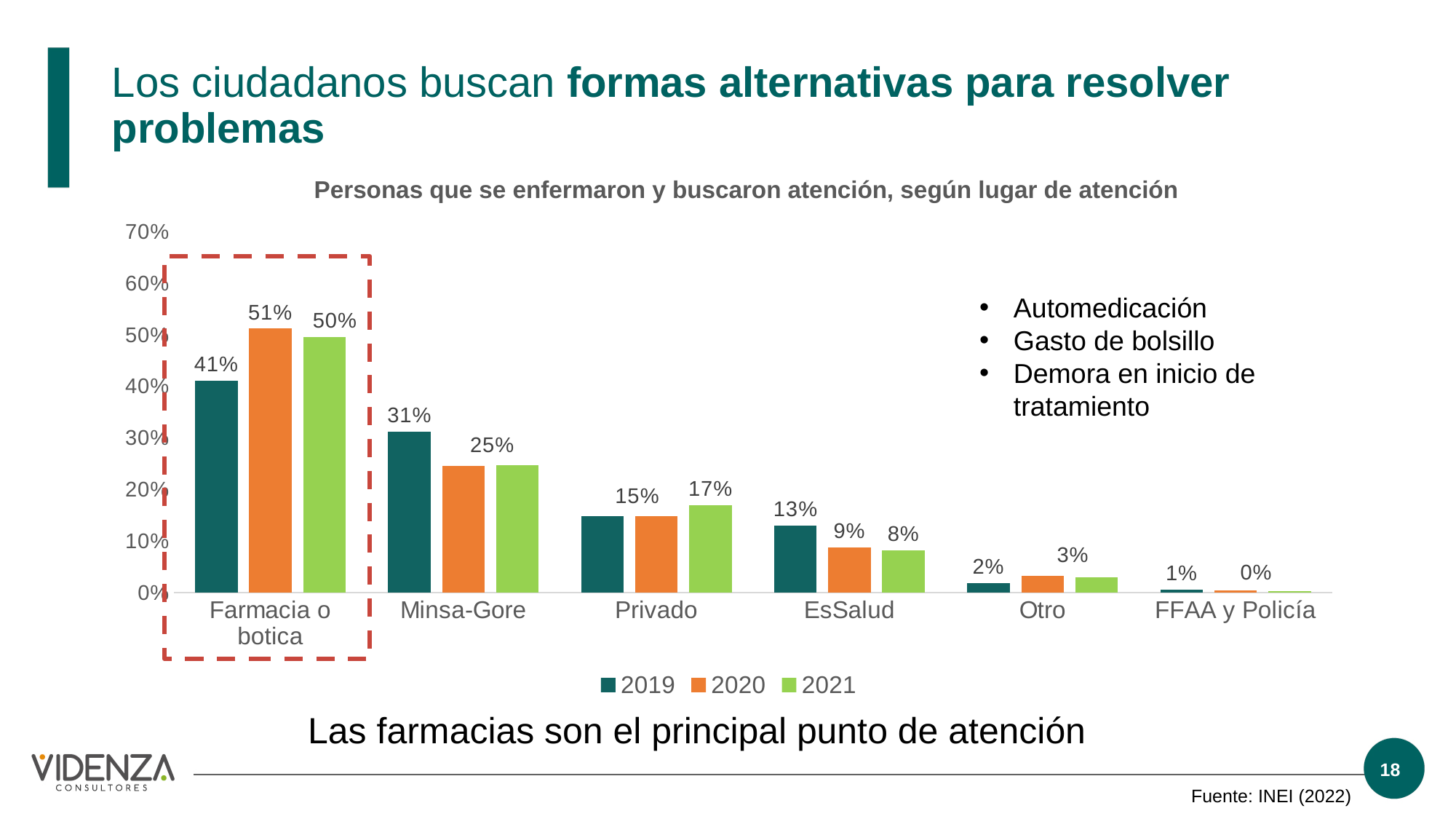
Which place of care has the highest value in 2019? Farmacia o botica Is the value for Minsa-Gore in 2021 greater or less than 30%? less How many places of care are shown on the x axis? 6 What is the value for Privado in 2021? 17% What is the value for EsSalud in 2019? 13% What is the value for Minsa-Gore in 2019? 31% Which place of care has the lowest value in 2019? FFAA y Policía How many series does the legend list? 3 What is the value for Farmacia o botica in 2020? 51% By how many percentage points did Farmacia o botica increase from 2019 to 2020? 10 percentage points Does the value for EsSalud rise or fall from 2019 to 2021? fall For EsSalud, which year has the larger value, 2019 or 2021? 2019